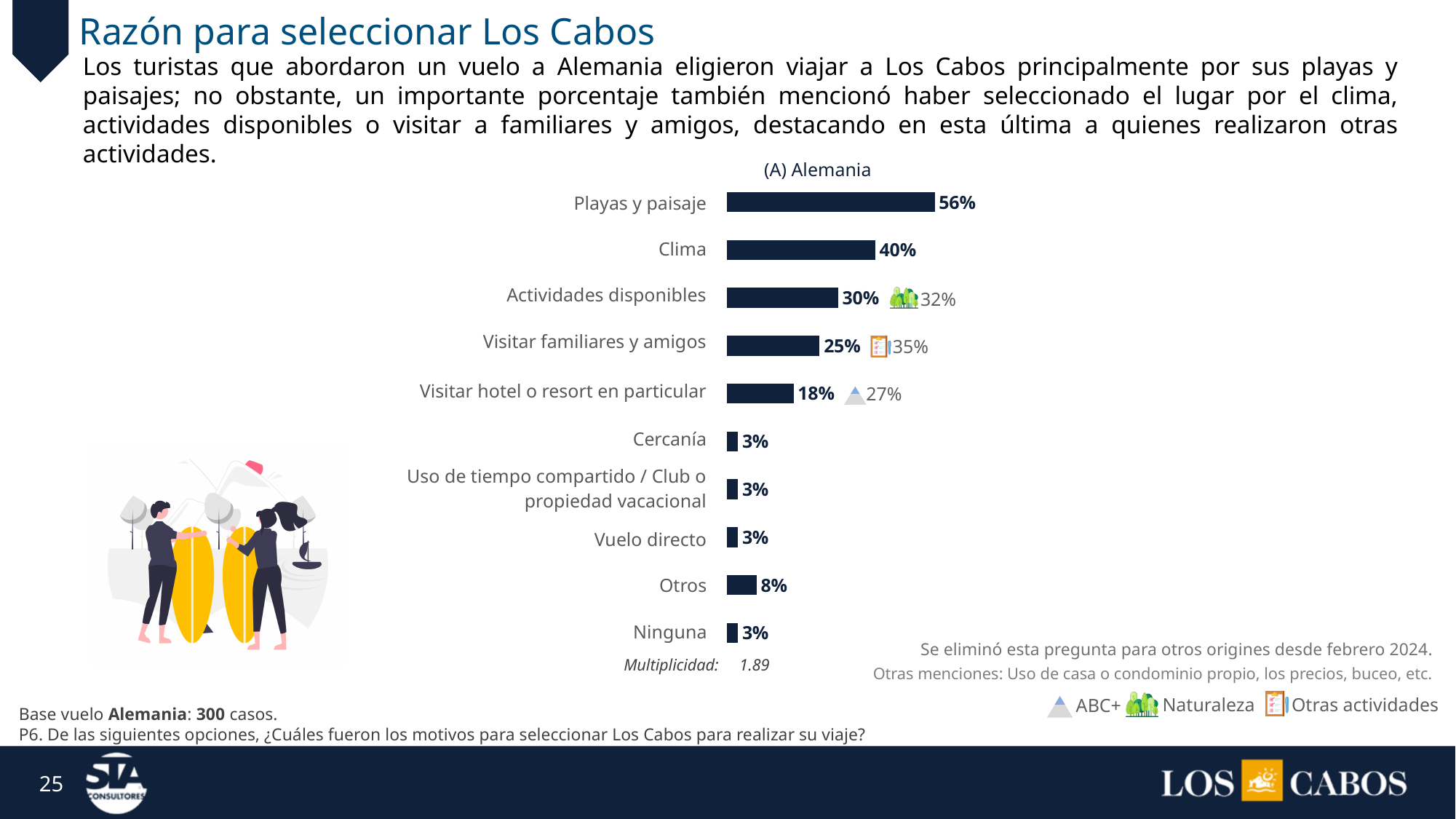
What is the value for Otros? 8% What is the title shown above the chart? (A) Alemania What is the value for Clima? 40% Which is larger, Otros or Cercanía? Otros What is the value for Playas y paisaje? 56% What is the value for Visitar hotel o resort en particular? 18% What is the difference between Actividades disponibles and Visitar familiares y amigos? 5% What is the difference between Playas y paisaje and Clima? 16% What kind of chart is shown? Bar chart How many categories are shown in the chart? 10 Which category has the highest value? Playas y paisaje What is the Multiplicidad value shown below the chart? 1.89